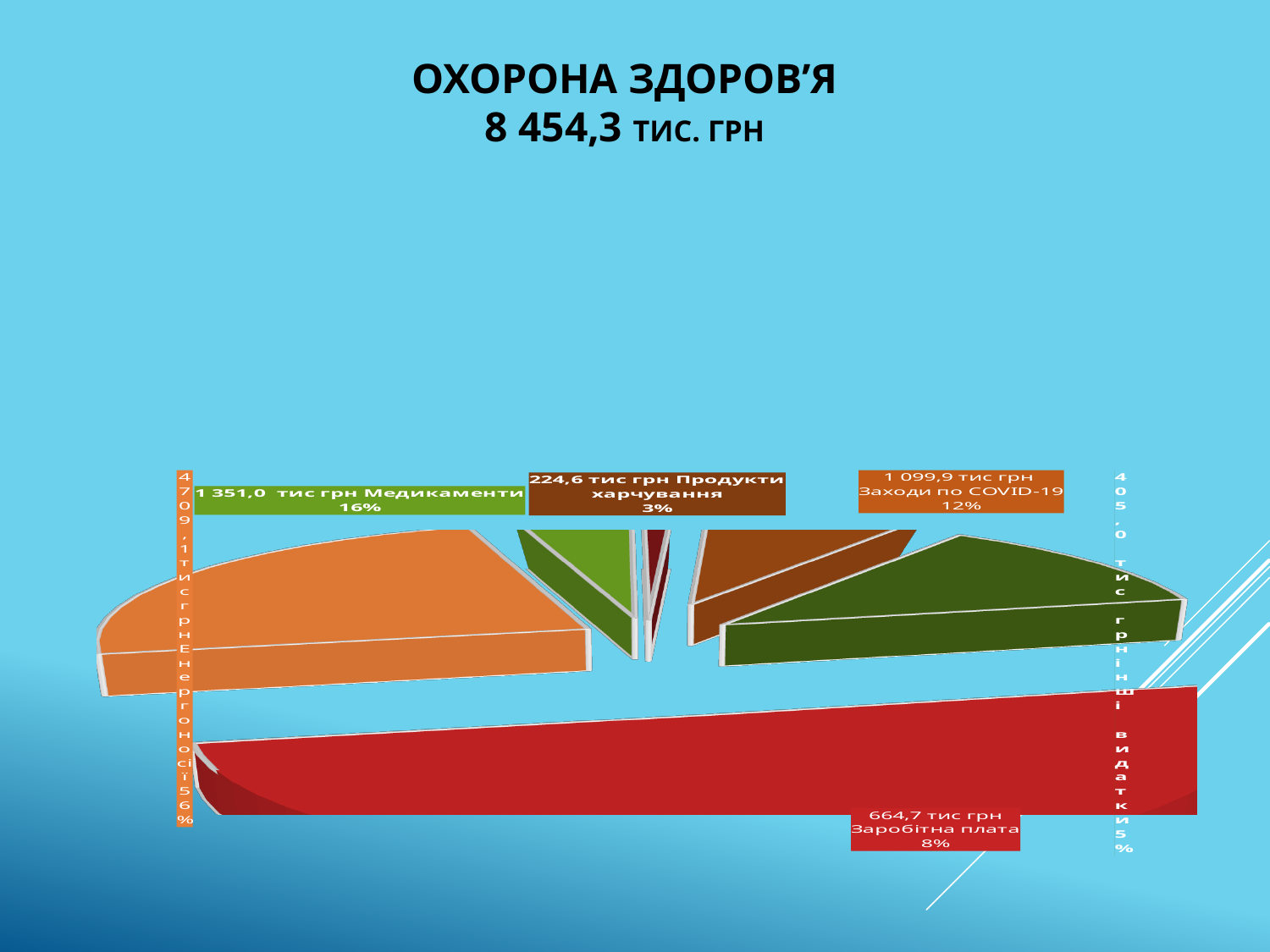
What is the value for Медикаменти? 1 351,0 тис грн What is the value for Заходи по COVID-19? 1 099,9 тис грн Which is larger, the value for Заробітна плата or the value for Інші видатки? Заробітна плата What share of the pie does Медикаменти represent? 16% What is the difference between the values for Медикаменти and Заходи по COVID-19? 251,1 тис грн What is the value for Заробітна плата? 664,7 тис грн Which category has the smallest slice of the pie? Продукти харчування How many categories does the pie chart have? 6 What is the value for Енергоносії? 4 709,1 тис грн What kind of chart is shown on the slide? pie chart What share of the pie does Інші видатки represent? 5%